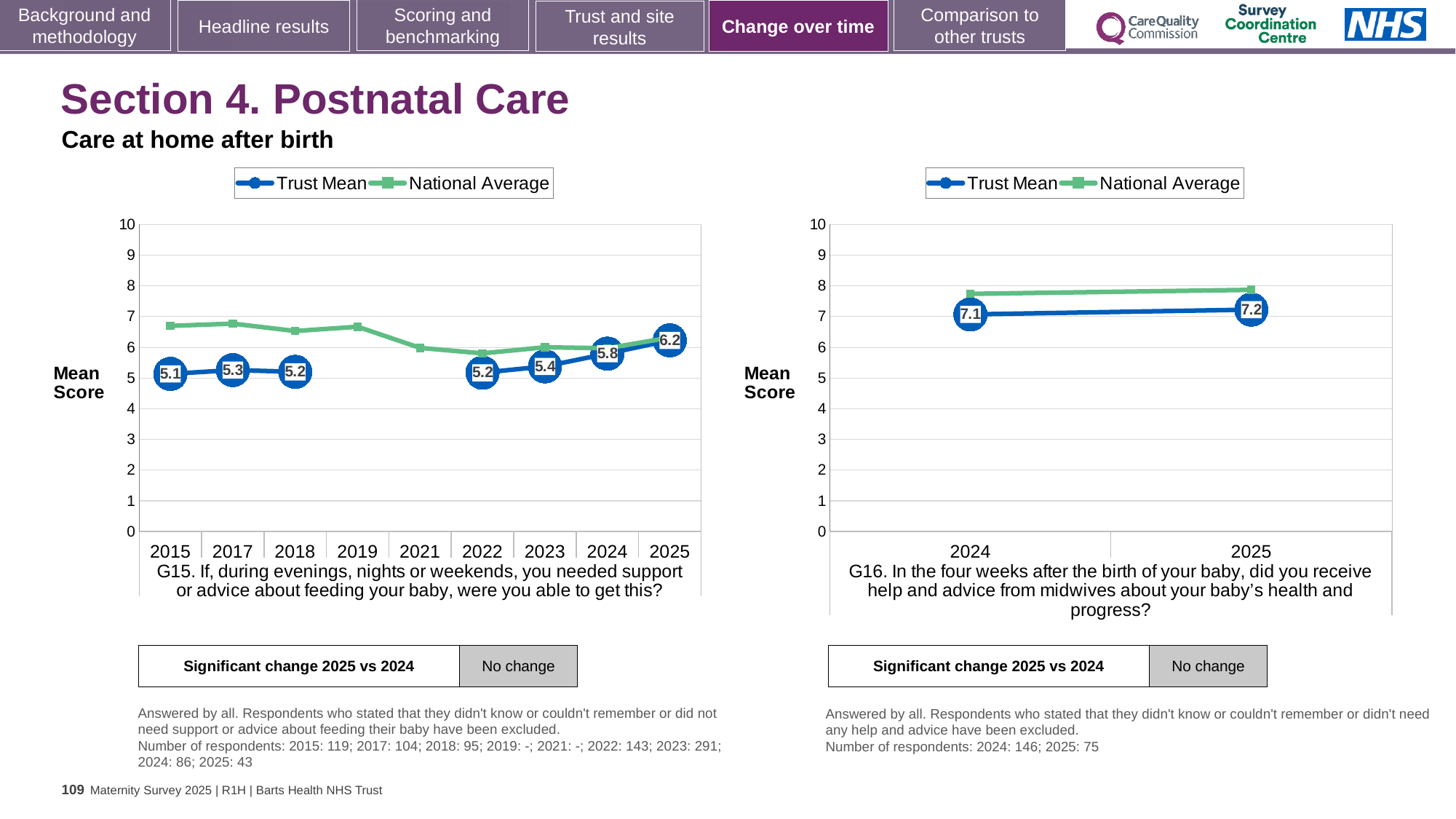
In the G15 chart on the left, what is the Trust Mean score for 2015? 5.1 In the G15 chart on the left, is the Trust Mean score for 2023 higher or lower than for 2024? lower In the G16 chart on the right, is the National Average for 2024 greater or less than 7? greater How many series does the legend of the G16 chart on the right list? 2 In the G15 chart on the left, is the National Average for 2015 greater or less than 6? greater In the G15 chart on the left, what is the Trust Mean score for 2025? 6.2 In the G15 chart on the left, which year has the lowest Trust Mean score? 2015 In the G16 chart on the right, what is the difference between the Trust Mean scores for 2025 and 2024? 0.1 In the G15 chart on the left, which year has the highest Trust Mean score? 2025 In the G15 chart on the left, what is the difference between the Trust Mean scores for 2025 and 2024? 0.4 How many years are shown on the x axis of the G15 chart on the left? 9 In the G16 chart on the right, what is the Trust Mean score for 2024? 7.1